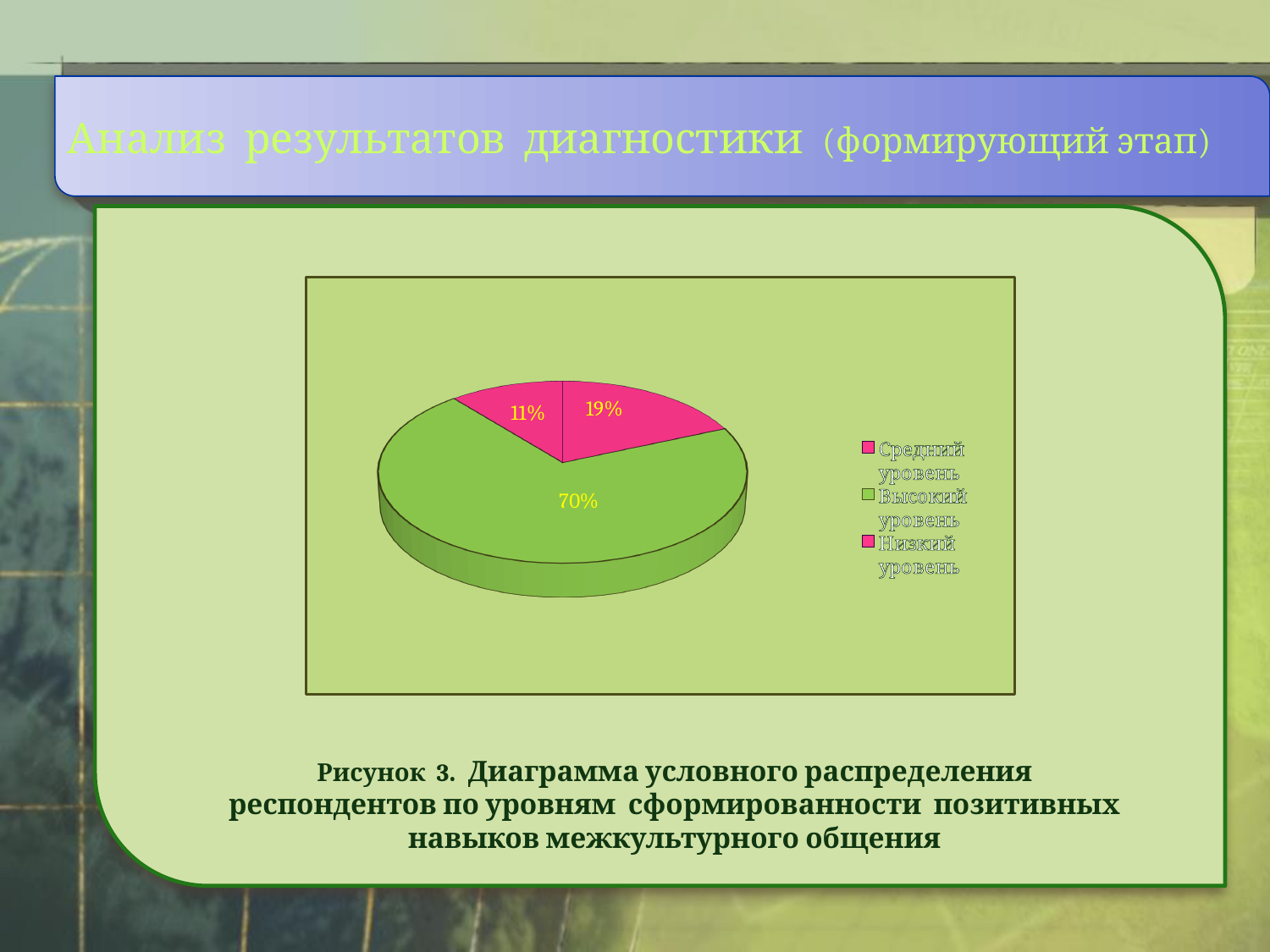
What is the share of the pie for Высокий уровень? 70% What is the difference in percentage points between the largest slice (70%) and the smallest slice (11%)? 59 What percentage is shown for the smallest slice of the pie chart? 11% What percentage is shown for the largest slice of the pie chart? 70% What colour is the slice for Высокий уровень in the pie chart? green Which is larger, the slice labelled 19% or the slice labelled 11%? 19% How many slices does the pie chart have? 3 What is the difference in percentage points between the 19% slice and the 11% slice? 8 What is the total of the three percentages shown on the pie chart? 100% Which level has the largest share of the pie chart? Высокий уровень What kind of chart is shown on the slide? pie chart How many entries does the legend of the pie chart list? 3